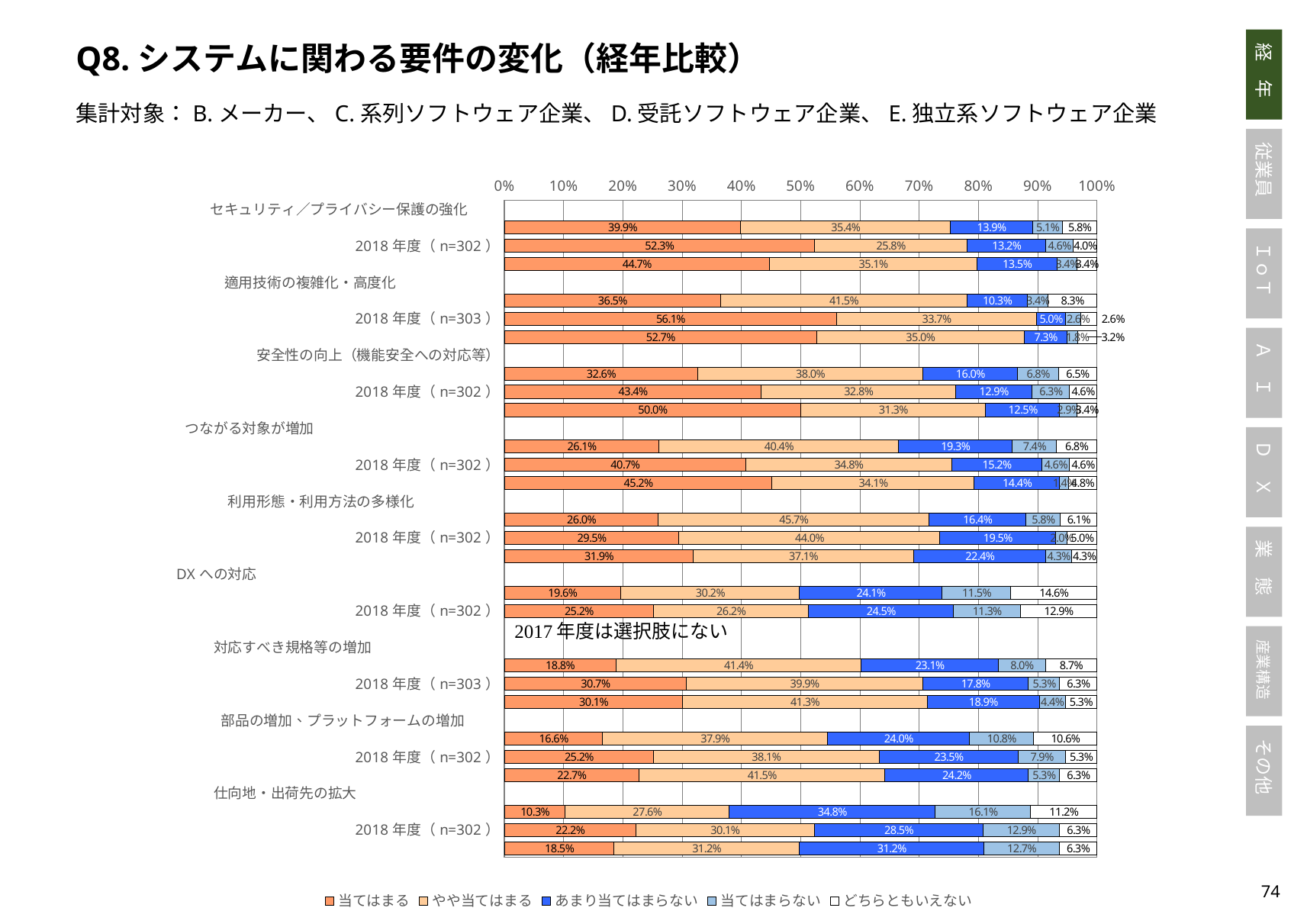
In the 2018 年度 bar for 安全性の向上（機能安全への対応等）, what is the difference between 当てはまる and やや当てはまる? 10.6 percentage points Among the 2018 年度 bars, which category has the lowest 当てはまる value? 仕向地・出荷先の拡大 In the 2018 年度 bar for 対応すべき規格等の増加, what is the value for どちらともいえない? 6.3% In the 2018 年度 bar for 適用技術の複雑化・高度化, what is the value for 当てはまる? 56.1% In the 2018 年度 bar for DX への対応, what is the value for 当てはまる? 25.2% In the 2018 年度 bar for セキュリティ／プライバシー保護の強化, what is the value for 当てはまる? 52.3% How many requirement categories (row groups) are shown in the chart? 9 What kind of chart is shown on the slide? stacked bar chart In the 2018 年度 bar for つながる対象が増加, which is larger: 当てはまる or やや当てはまる? 当てはまる In the 2018 年度 bar for 仕向地・出荷先の拡大, what is the value for あまり当てはまらない? 28.5% Among the 2018 年度 bars, which category has the highest 当てはまる value? 適用技術の複雑化・高度化 How many series does the legend list? 5